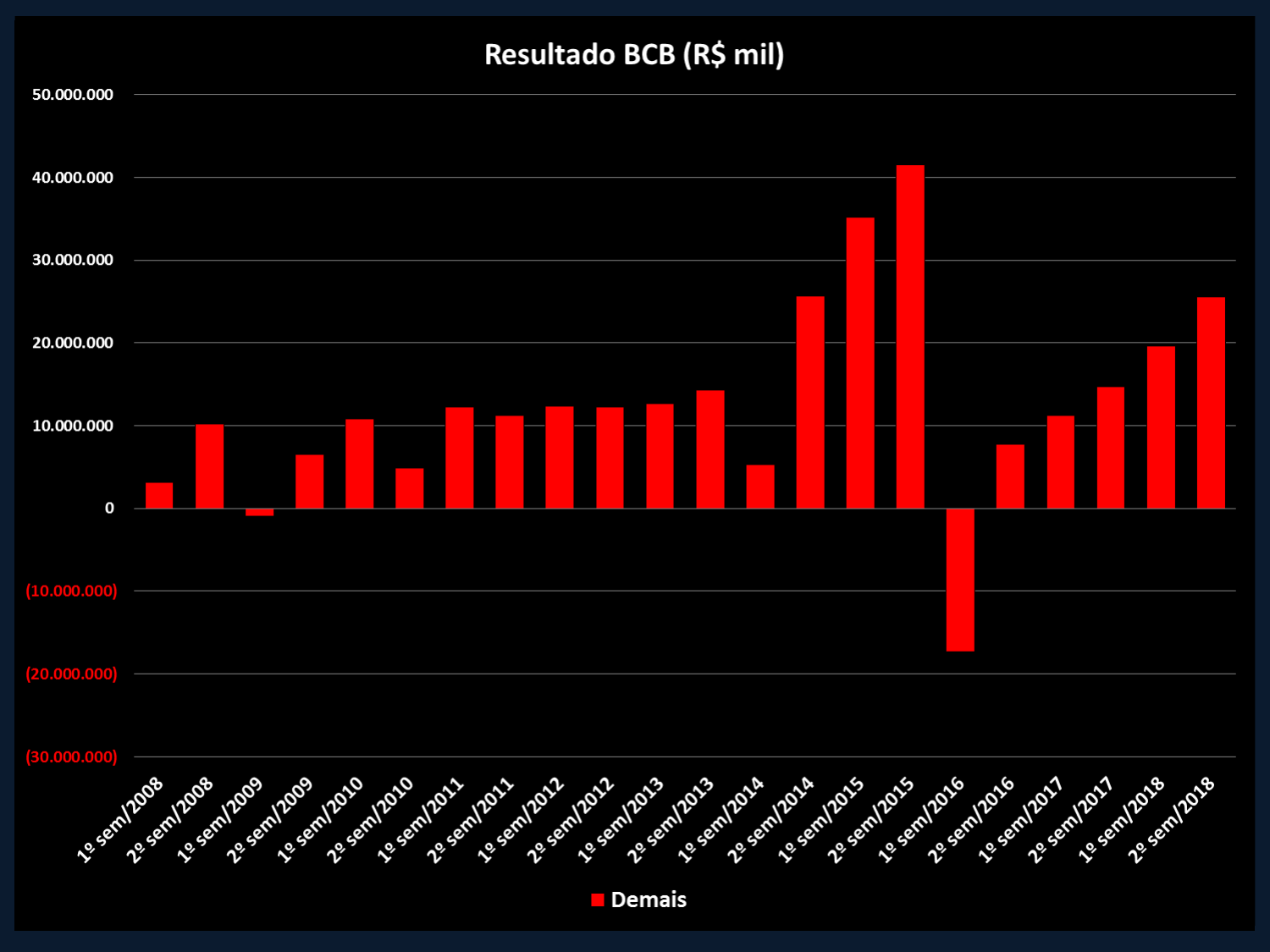
Is the value for 1º sem/2016 greater or less than (10.000.000)? less What is the title of the chart? Resultado BCB (R$ mil) Do the values rise or fall from 2º sem/2016 to 2º sem/2018? rise Is the value for 2º sem/2010 greater or less than 10.000.000? less How many series does the legend list? 1 How many semesters (categories) are plotted on the x axis? 22 Which semester has the highest value? 2º sem/2015 Which semester has the lowest value? 1º sem/2016 Is the value for 2º sem/2015 greater or less than 40.000.000? greater Which is larger, the value for 1º sem/2015 or the value for 2º sem/2014? 1º sem/2015 What kind of chart is shown on the slide? bar chart What is the name of the series shown in the legend? Demais